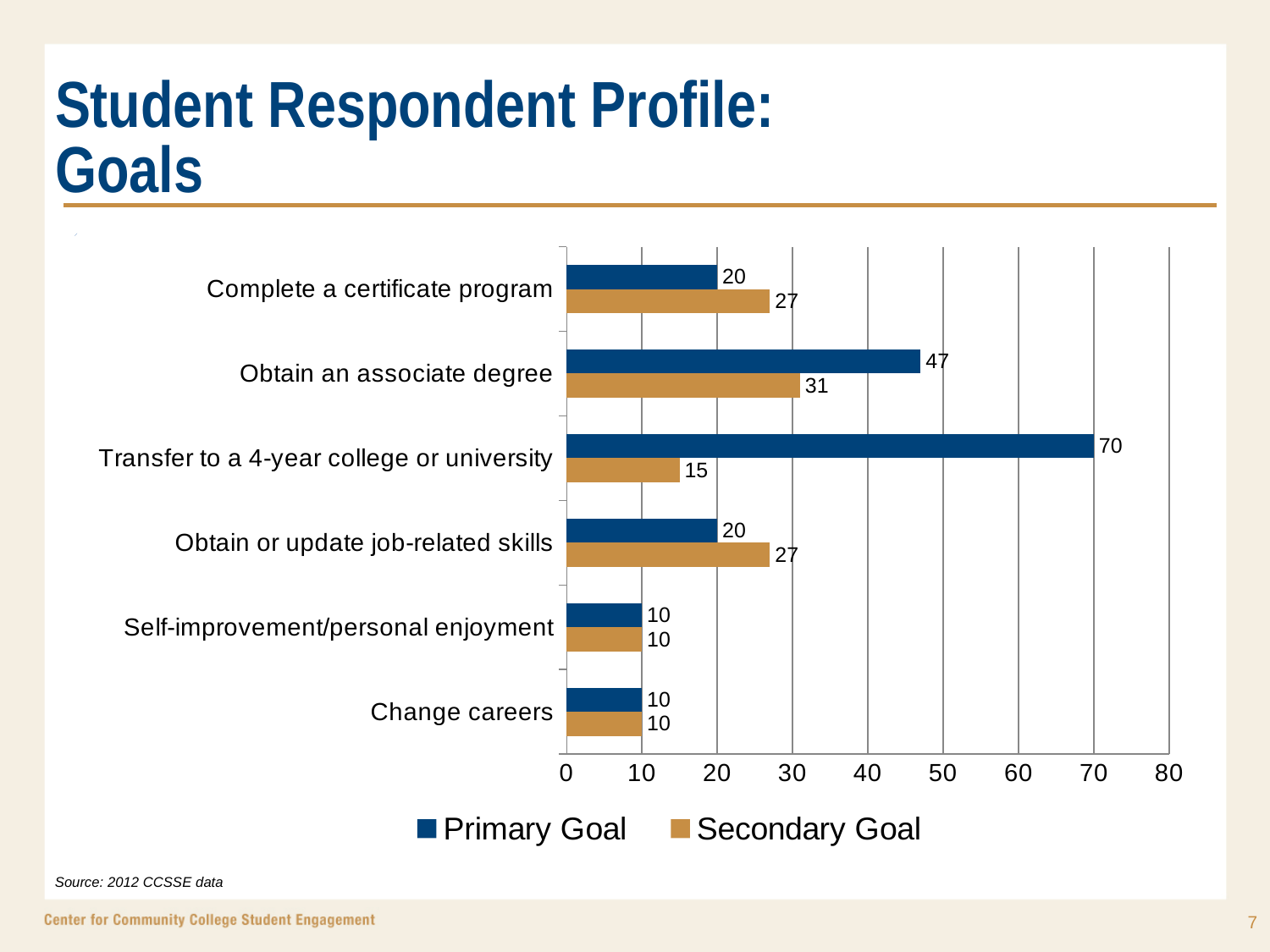
What is the Primary Goal value for "Transfer to a 4-year college or university"? 70 Which category has the highest Primary Goal value? Transfer to a 4-year college or university How many series does the legend list? 2 For "Obtain or update job-related skills", which is larger: the Primary Goal or the Secondary Goal value? Secondary Goal What is the Secondary Goal value for "Complete a certificate program"? 27 What kind of chart is shown on the slide? Bar chart What is the difference between the Primary Goal and Secondary Goal values for "Transfer to a 4-year college or university"? 55 What is the difference between the Primary Goal values for "Obtain an associate degree" and "Complete a certificate program"? 27 What are the two series named in the legend? Primary Goal and Secondary Goal What is the Secondary Goal value for "Obtain an associate degree"? 31 Which category has the lowest Secondary Goal value? Self-improvement/personal enjoyment and Change careers (both 10) How many goal categories are shown on the chart? 6